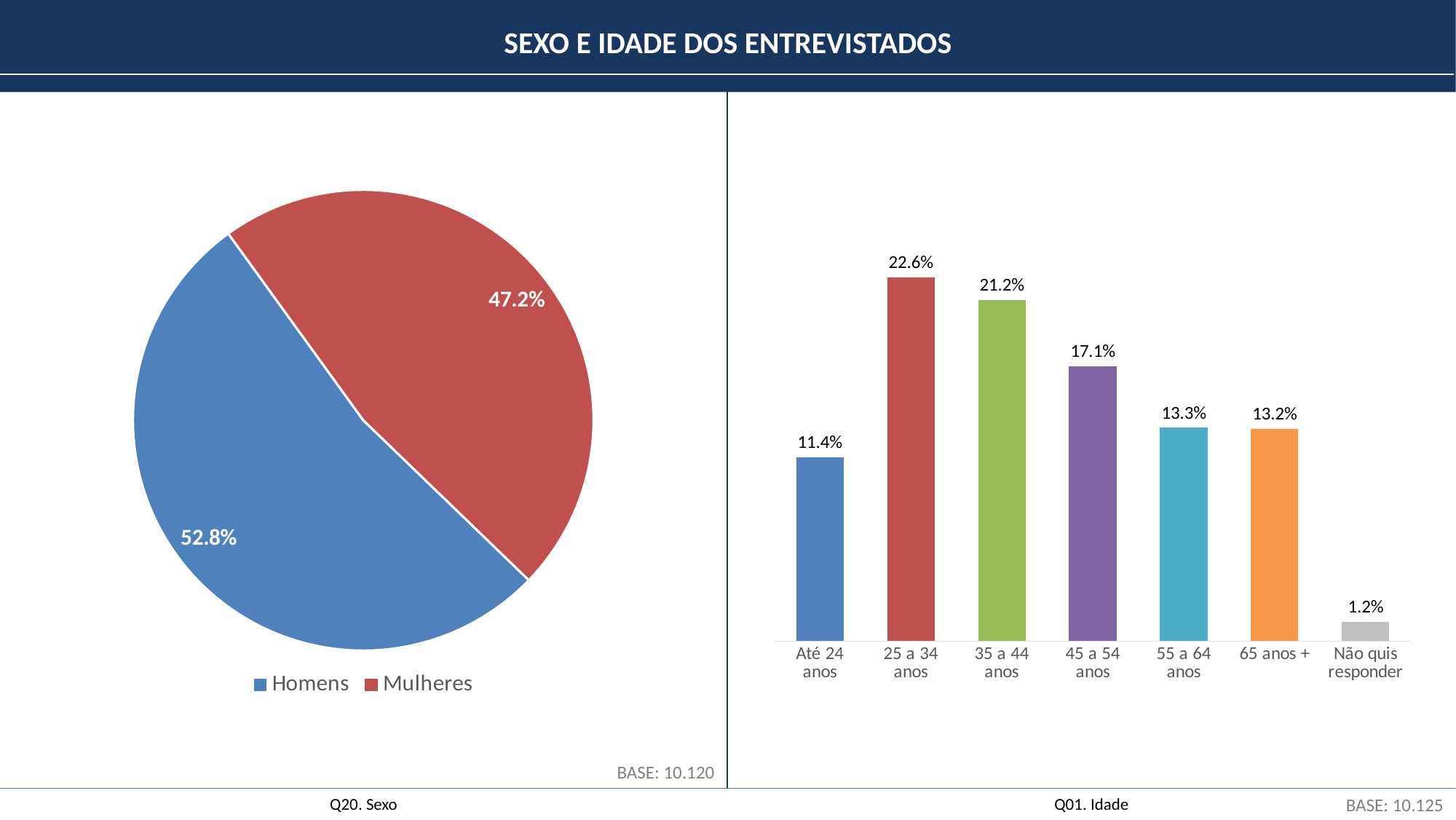
In the pie chart on the left, which slice is larger, Homens or Mulheres? Homens In the bar chart on the right, which category has the highest value? 25 a 34 anos In the bar chart on the right, which is larger, the value for Até 24 anos or the value for 55 a 64 anos? 55 a 64 anos In the bar chart on the right, what is the value for 65 anos +? 13.2% In the pie chart on the left, what share is shown for Homens? 52.8% What kind of chart is shown on the right side of the slide? Bar chart In the bar chart on the right, which category has the lowest value? Não quis responder In the bar chart on the right, what is the difference between the values for 35 a 44 anos and 45 a 54 anos? 4.1% In the bar chart on the right, what is the value for 25 a 34 anos? 22.6% In the pie chart on the left, what share is shown for Mulheres? 47.2% In the bar chart on the right, how many categories are shown on the x axis? 7 In the pie chart on the left, how many entries does the legend list? 2